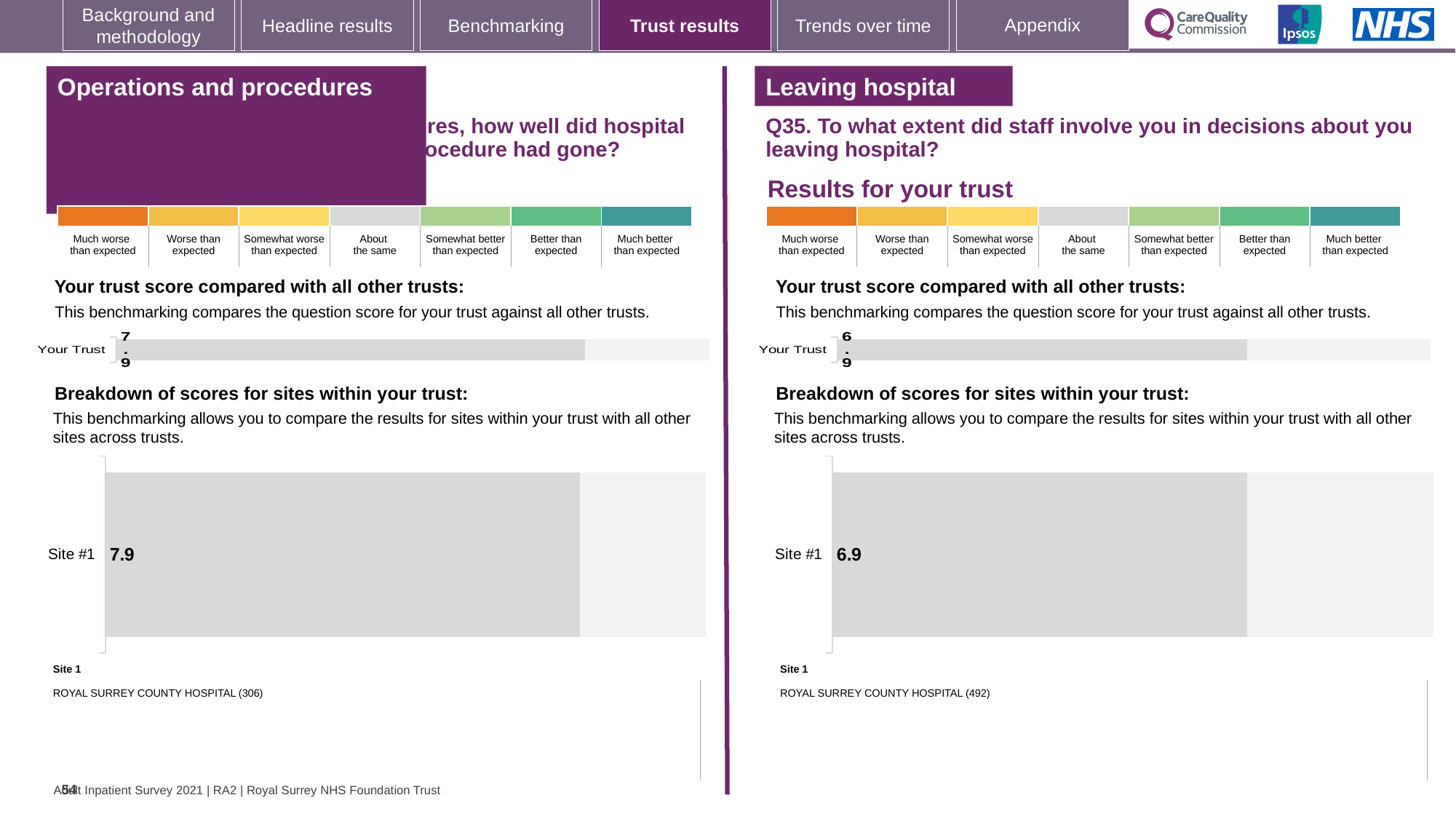
What type of chart is used to show the 'Your Trust' score in the right-hand 'Leaving hospital' section? Bar chart In the left-hand 'Operations and procedures' section, what score is shown for Site #1 in the breakdown of scores for sites chart? 7.9 How many sites are plotted in the breakdown of scores for sites chart in the left-hand 'Operations and procedures' section? 1 In the right-hand 'Leaving hospital' section, what score is shown for Site #1 in the breakdown of scores for sites chart? 6.9 What is the difference between the 'Your Trust' score in the left-hand 'Operations and procedures' section and the 'Your Trust' score in the right-hand 'Leaving hospital' section? 1.0 In the left-hand 'Operations and procedures' section, what is the 'Your Trust' score shown on the trust comparison bar chart? 7.9 In the right-hand 'Leaving hospital' section, which hospital is listed as Site 1 below the breakdown chart? ROYAL SURREY COUNTY HOSPITAL (492) Which is larger: the Site #1 score in the left-hand 'Operations and procedures' breakdown chart or the Site #1 score in the right-hand 'Leaving hospital' breakdown chart? Operations and procedures (7.9) How many sites are plotted in the breakdown of scores for sites chart in the right-hand 'Leaving hospital' section? 1 What type of chart is used to show the Site #1 score in the left-hand 'Operations and procedures' section? Bar chart In the right-hand 'Leaving hospital' section, what is the 'Your Trust' score shown on the trust comparison bar chart? 6.9 In the left-hand 'Operations and procedures' section, which hospital is listed as Site 1 below the breakdown chart? ROYAL SURREY COUNTY HOSPITAL (306)